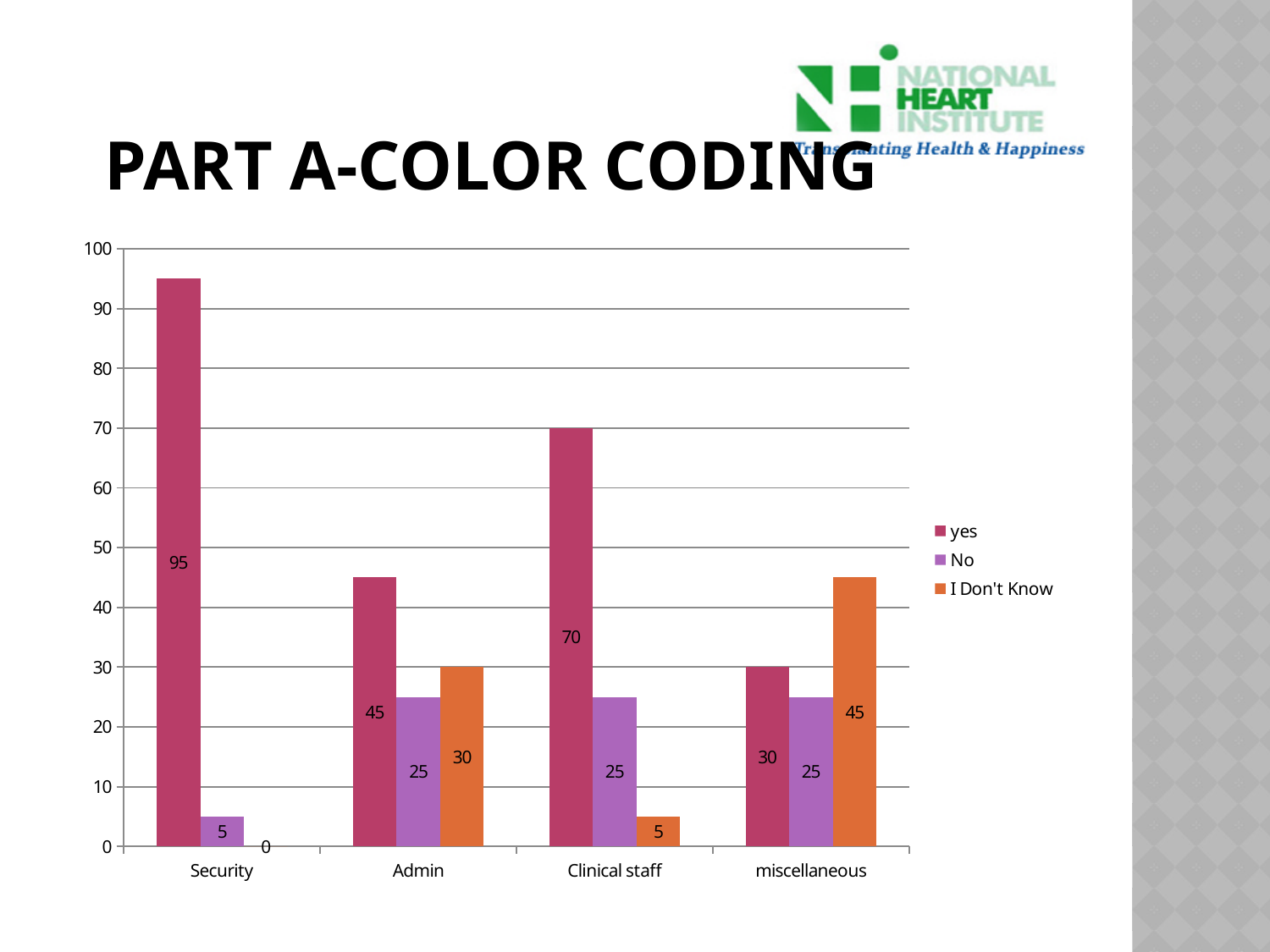
What is the total of the three values for miscellaneous? 100 What is the 'I Don't Know' value for miscellaneous? 45 What is the 'No' value for Clinical staff? 25 What kind of chart is shown on the slide? Bar chart What is the 'yes' value for Security? 95 How many categories are shown on the x axis? 4 What is the title of the slide? PART A-COLOR CODING Which category has the highest 'yes' value? Security Which category has the lowest 'I Don't Know' value? Security How many series does the legend list? 3 What is the difference between the 'yes' values for Security and Clinical staff? 25 Which is larger for Admin: the 'yes' value or the 'I Don't Know' value? yes